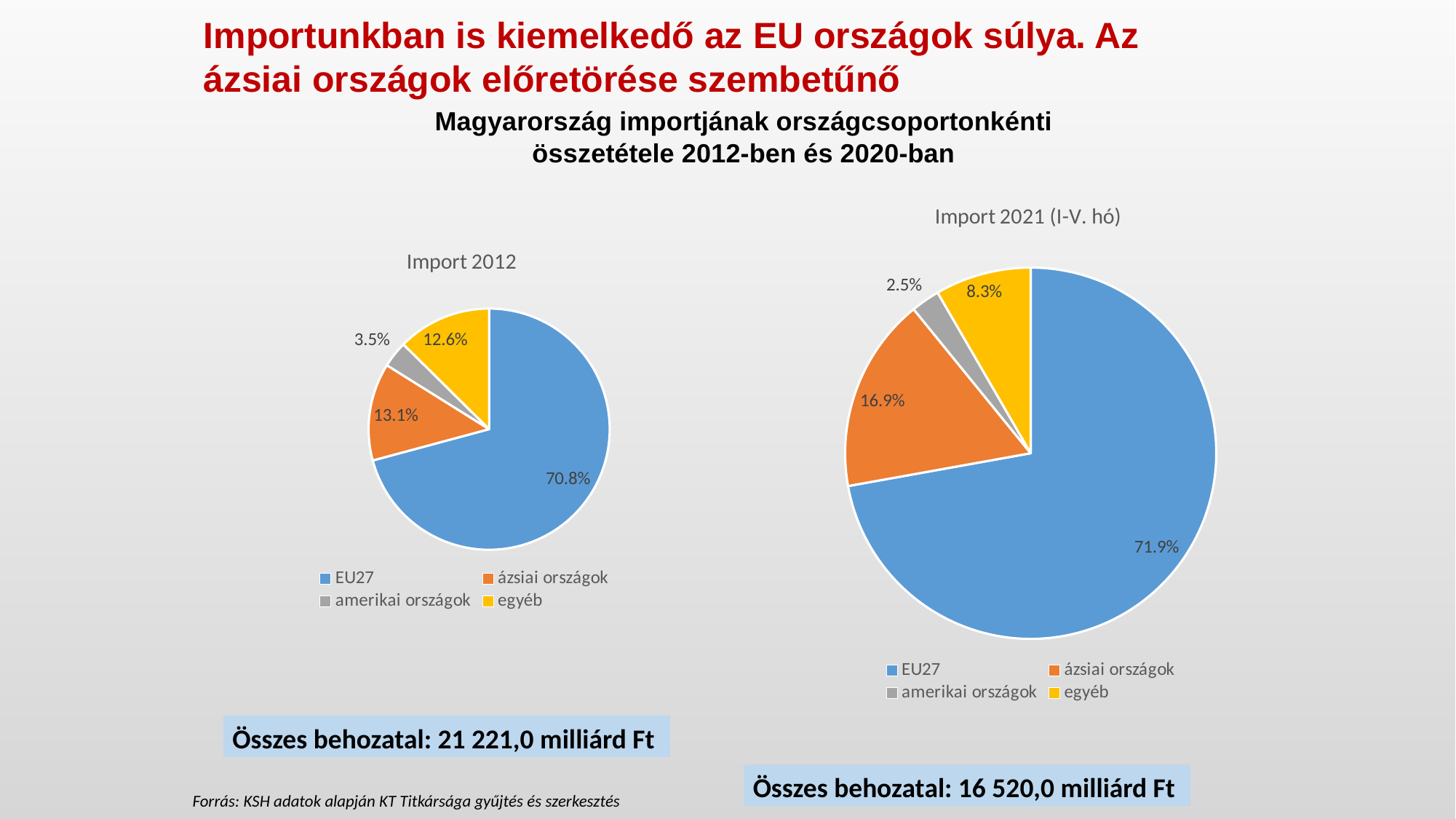
Which is larger: the egyéb share in the 'Import 2012' chart or the egyéb share in the 'Import 2021 (I-V. hó)' chart? Import 2012 In the 'Import 2021 (I-V. hó)' pie chart, what share does egyéb have? 8.3% How many slices does the 'Import 2012' pie chart have? 4 In the 'Import 2021 (I-V. hó)' pie chart, which category has the smallest share? amerikai országok What type of chart is the 'Import 2012' chart? Pie chart In the 'Import 2021 (I-V. hó)' pie chart, what is the difference in percentage points between the ázsiai országok share and the egyéb share? 8.6 In the 'Import 2012' pie chart, what share does EU27 have? 70.8% In the 'Import 2012' pie chart, what share do the ázsiai országok have? 13.1% In the 'Import 2021 (I-V. hó)' pie chart, what colour is the ázsiai országok slice? Orange In the 'Import 2021 (I-V. hó)' pie chart, what share do the amerikai országok have? 2.5% How many entries does the legend of the 'Import 2021 (I-V. hó)' chart list? 4 In the 'Import 2012' pie chart, which category has the largest share? EU27